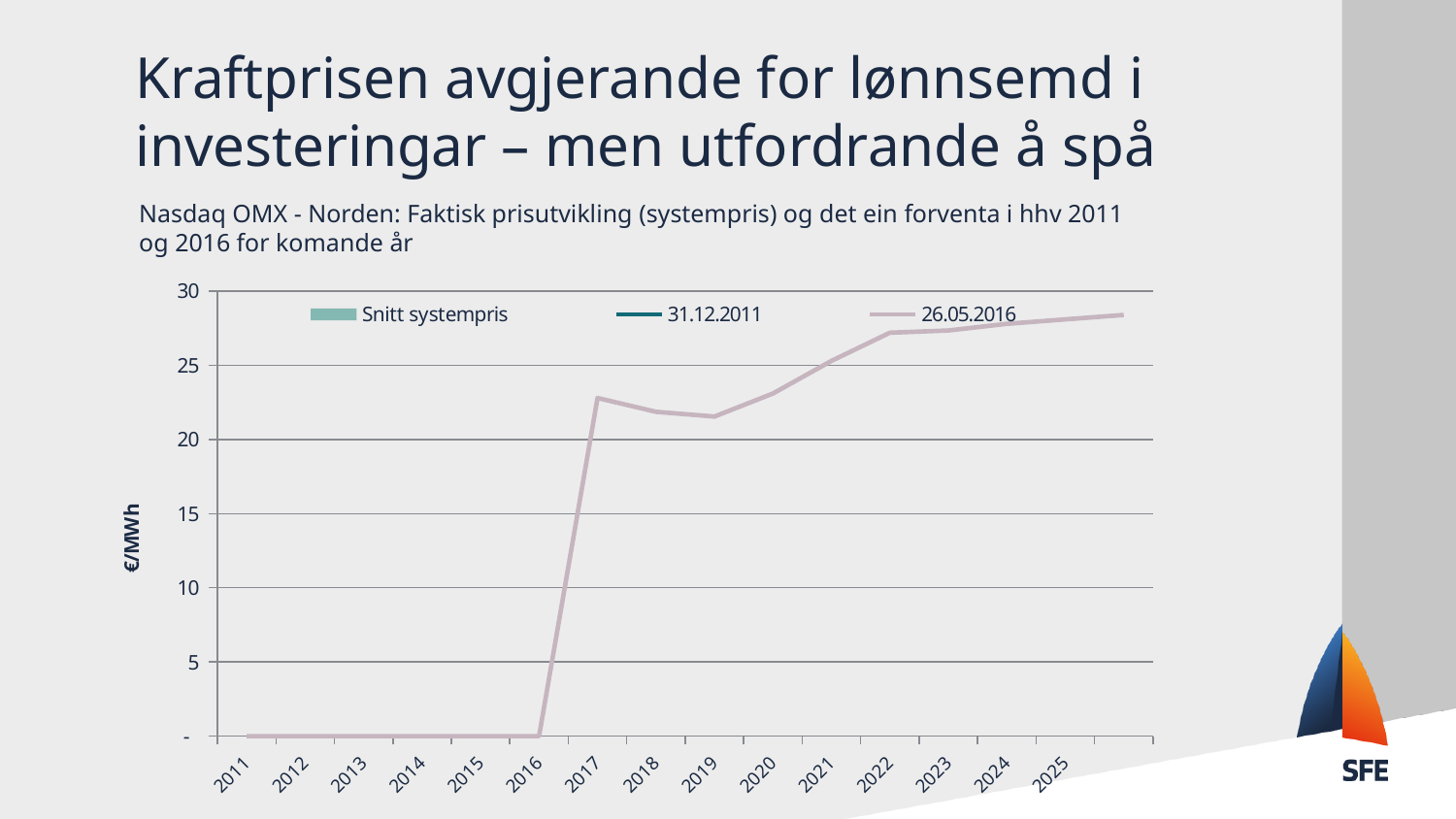
What kind of chart is shown on the slide? line chart How many years are shown on the x axis of the chart? 15 Is the value for 2017 greater or less than 25? less Is the value for 2022 greater or less than 25? greater Which is larger, the value for 2025 or the value for 2019? 2025 How many series does the chart legend list? 3 Is the value for 2019 greater or less than 20? greater What are the three entries in the chart legend? Snitt systempris, 31.12.2011, 26.05.2016 What is the unit shown on the y axis of the chart? €/MWh